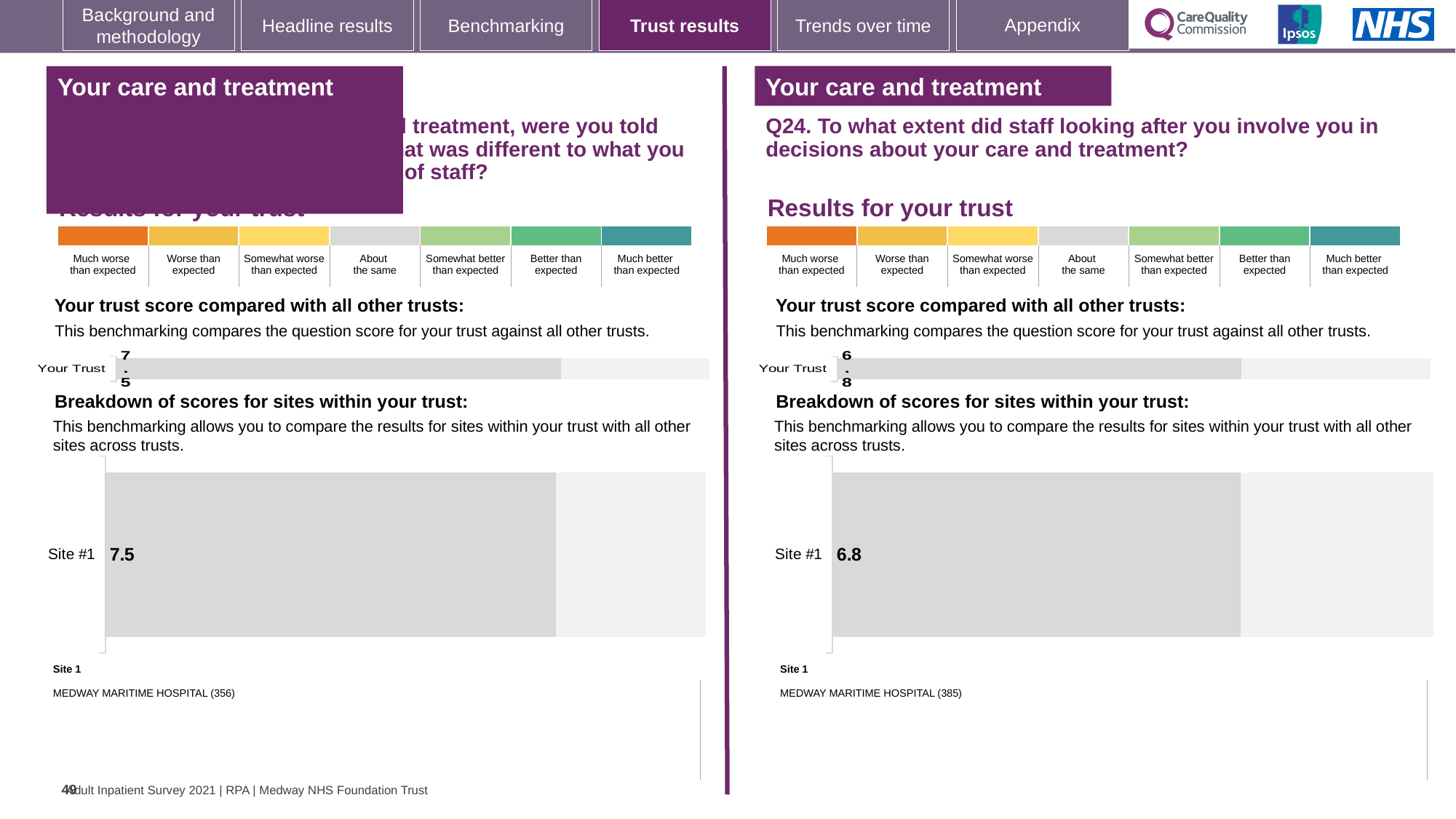
On the right-hand side of the slide (Q24), what is the score shown for Site #1? 6.8 On the left-hand side of the slide, what score is shown for 'Your Trust' in the trust benchmarking bar? 7.5 Is the Site #1 score on the right-hand (Q24) chart greater or less than the Site #1 score on the left-hand chart? less On the left-hand side of the slide, what is the score shown for Site #1? 7.5 How many sites are shown in the 'Breakdown of scores for sites within your trust' chart on the left-hand side of the slide? 1 What is the difference between the Site #1 score on the left-hand chart (7.5) and the Site #1 score on the right-hand Q24 chart (6.8)? 0.7 What kind of chart is used to show the Site #1 score on the right-hand side of the slide? Bar chart On the right-hand side of the slide (Q24), what score is shown for 'Your Trust' in the trust benchmarking bar? 6.8 Which Site #1 score is larger: the one on the left-hand chart or the one on the right-hand (Q24) chart? The left-hand chart How many sites are shown in the 'Breakdown of scores for sites within your trust' chart on the right-hand side of the slide? 1 Which hospital is listed as Site 1 on the left-hand side of the slide? MEDWAY MARITIME HOSPITAL (356) Which hospital is listed as Site 1 on the right-hand side of the slide? MEDWAY MARITIME HOSPITAL (385)